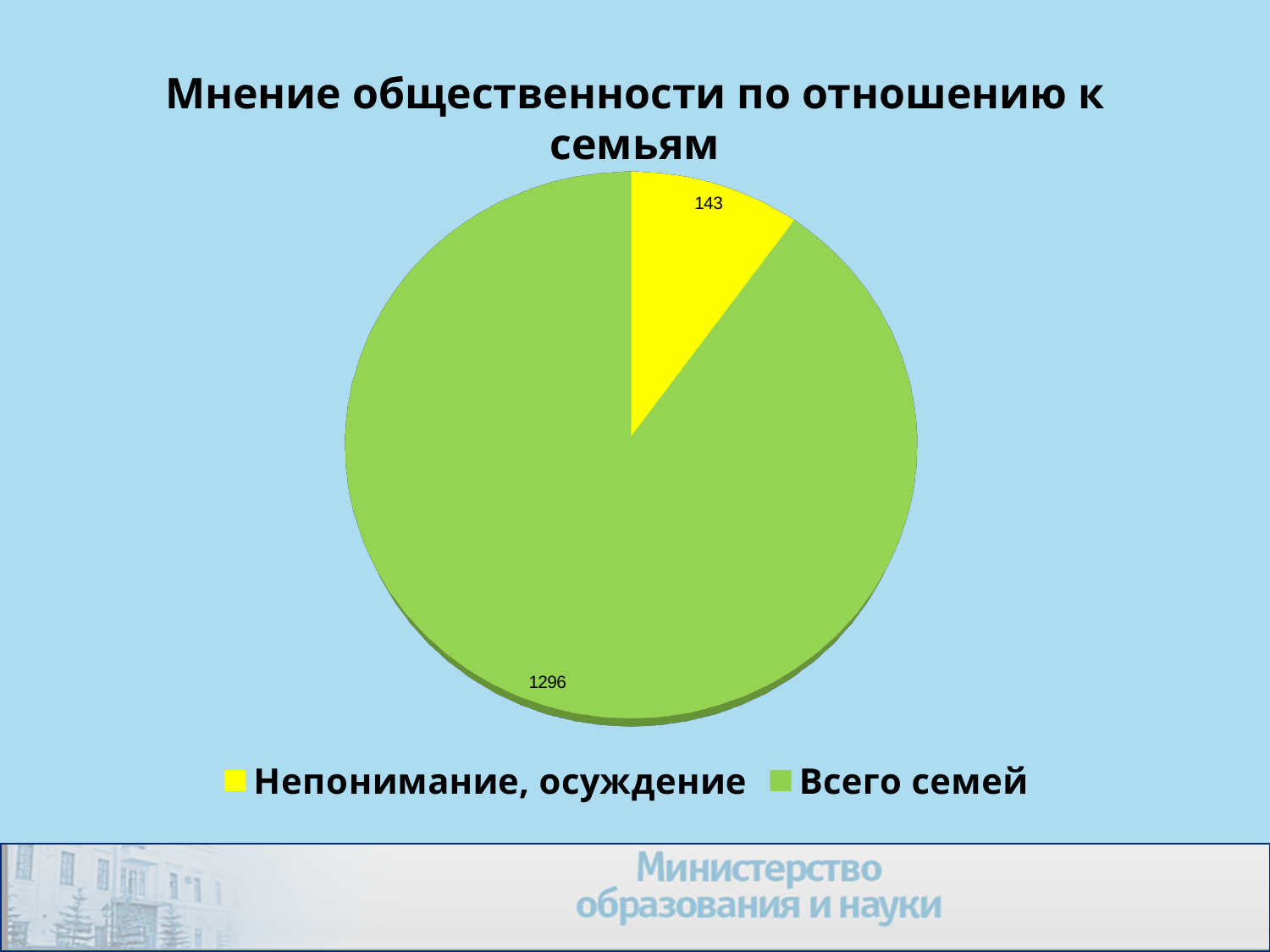
Which is larger: the value for "Непонимание, осуждение" or the value for "Всего семей"? Всего семей Which slice of the pie is the smallest? Непонимание, осуждение What is the value for "Всего семей"? 1296 What is the sum of the two values shown on the pie chart? 1439 What is the difference between the values for "Всего семей" and "Непонимание, осуждение"? 1153 What colour is the slice for "Непонимание, осуждение"? yellow How many slices does the pie chart have? 2 What is the title of the chart? Мнение общественности по отношению к семьям How many entries does the legend list? 2 What type of chart is shown on the slide? pie chart What is the value for "Непонимание, осуждение"? 143 Which slice of the pie is the largest? Всего семей